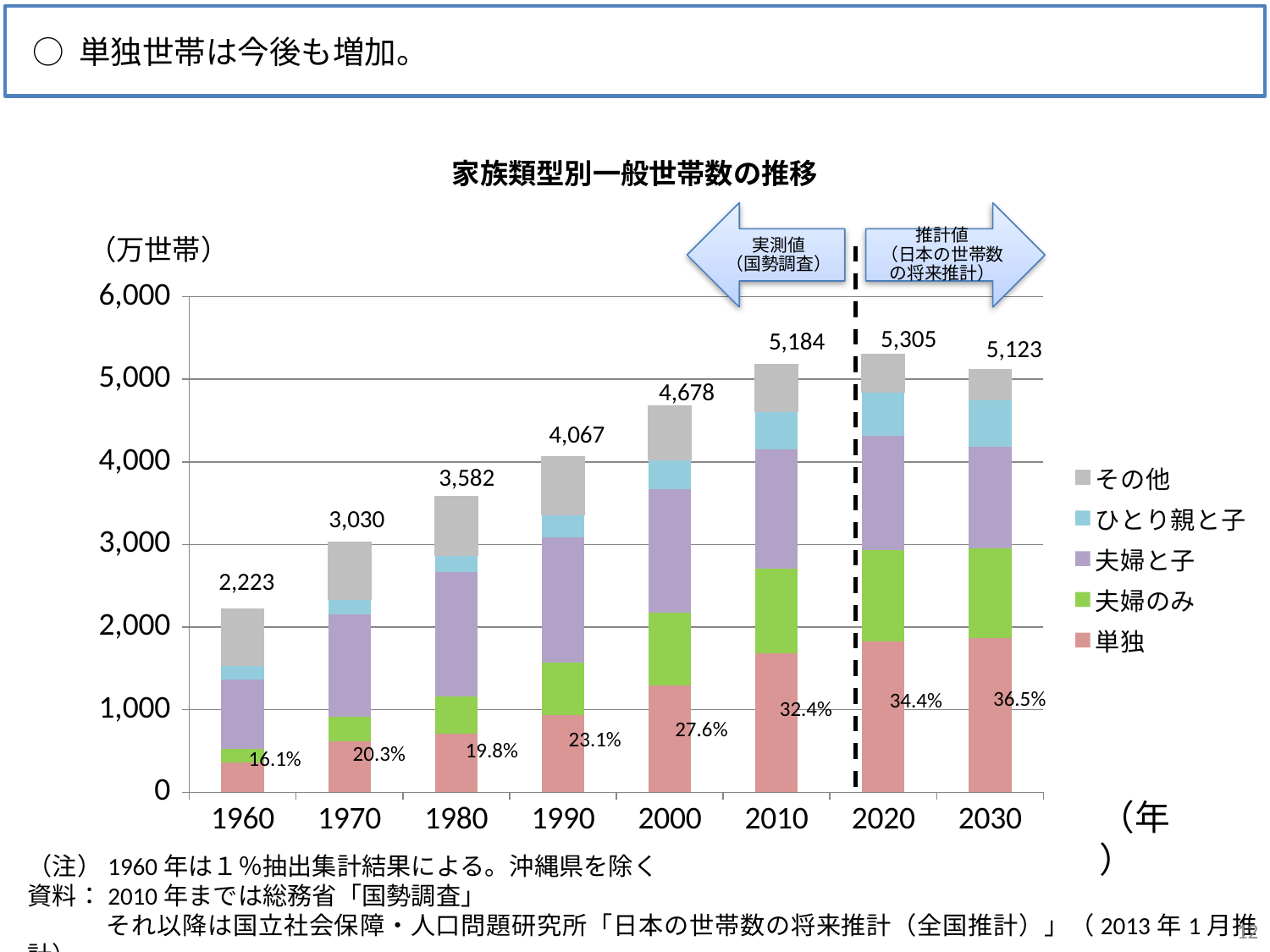
What percentage is labelled for the 単独 (single-person) segment in 2030? 36.5% What is the difference between the total for 2020 and the total for 2030? 182 How many years are shown on the x axis? 8 Which year has the lowest total number of households? 1960 What is the total number of households shown for 1960? 2,223 Is the 単独 segment in 2030 greater or less than 2,000? less What percentage is labelled for the 単独 segment in 1990? 23.1% What is the total number of households shown for 2010? 5,184 How many series does the legend list? 5 Which year has the highest total number of households? 2020 Which is larger, the total for 2010 or the total for 2030? 2010 What kind of chart is this? Stacked bar chart